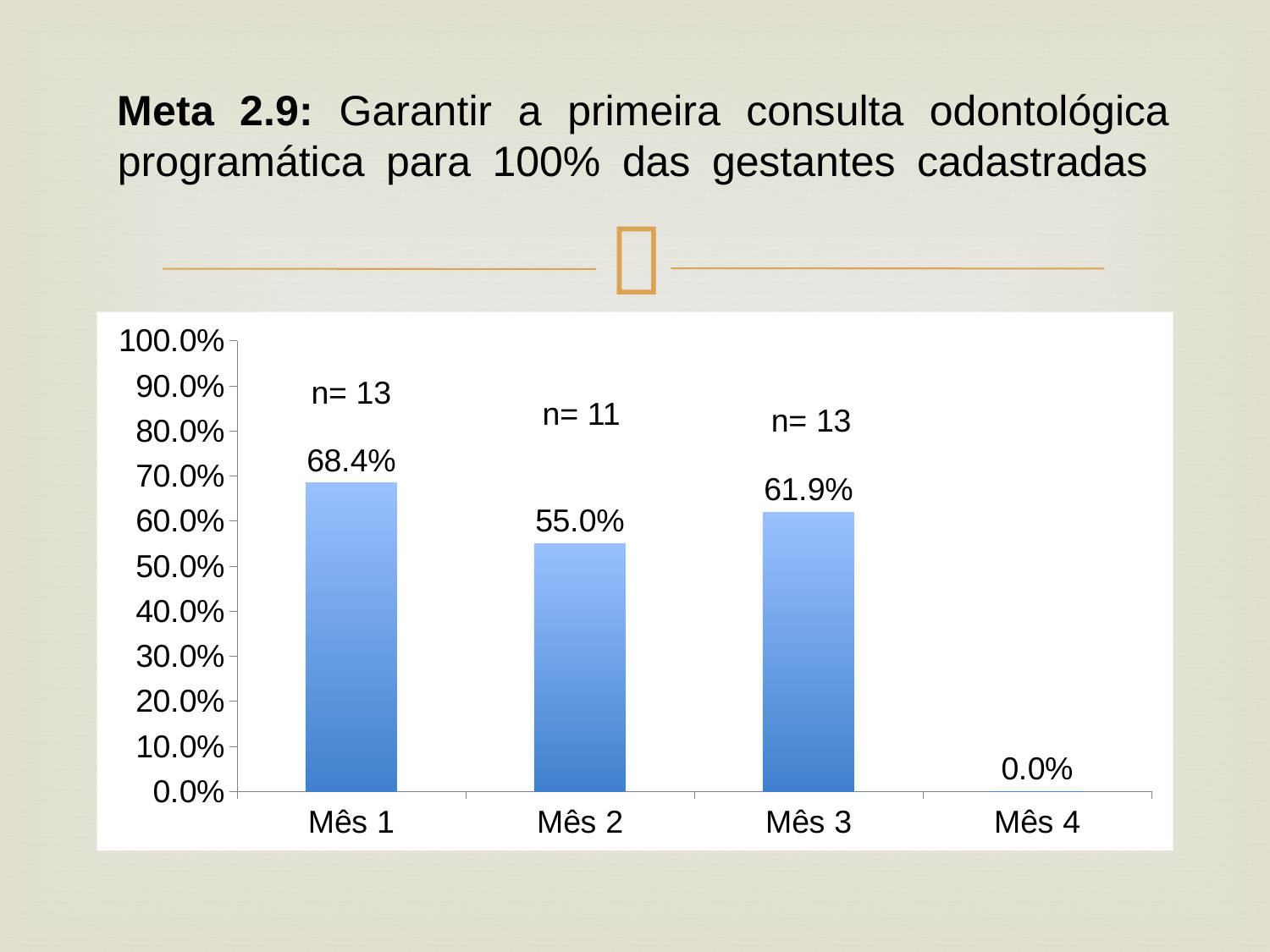
What is the value for Mês 1? 68.4% What is the difference between the values for Mês 1 and Mês 2? 13.4% Which month has the lowest value? Mês 4 What is the n value shown above the bar for Mês 2? n= 11 Which is larger, the value for Mês 2 or the value for Mês 3? Mês 3 Is the value for Mês 3 greater or less than 60.0%? greater What kind of chart is shown on the slide? bar chart What is the value for Mês 3? 61.9% What is the value for Mês 4? 0.0% What is the value for Mês 2? 55.0% How many months are shown on the x axis? 4 Which month has the highest value? Mês 1